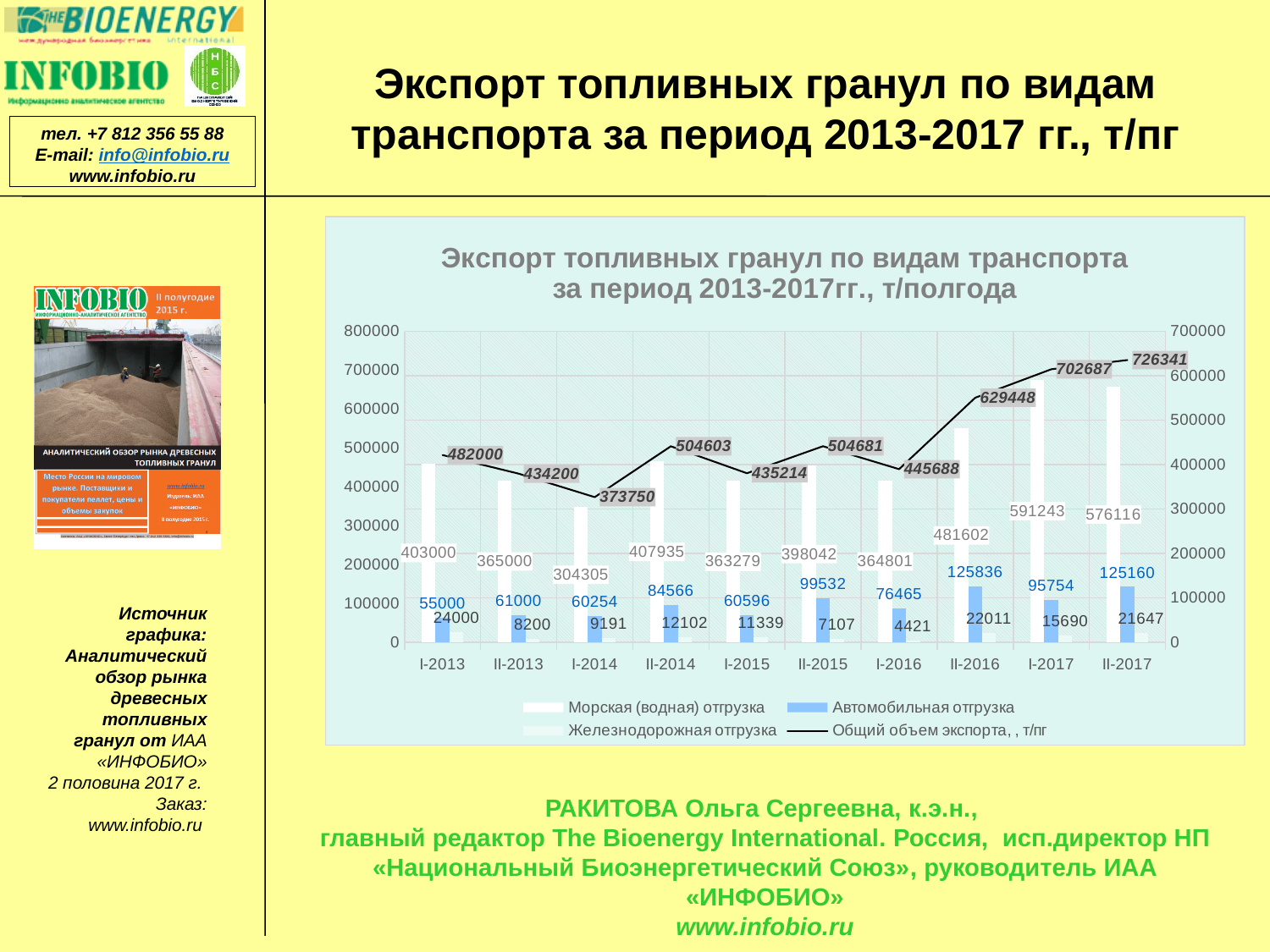
How many series does the legend list? 4 What is the value of Морская (водная) отгрузка for I-2017? 591243 Does Общий объем экспорта rise or fall from II-2016 to II-2017? Rises What is the value of Железнодорожная отгрузка for I-2016? 4421 What is the value of Общий объем экспорта for II-2017? 726341 What kind of chart is this? Bar chart with a line In which period is Железнодорожная отгрузка the lowest? I-2016 What is the difference between Общий объем экспорта in II-2017 and in I-2017? 23654 What is the value of Автомобильная отгрузка for II-2016? 125836 Which is larger: Автомобильная отгрузка in II-2015 or in I-2016? II-2015 How many periods are shown on the x axis? 10 In which period is Общий объем экспорта the highest? II-2017